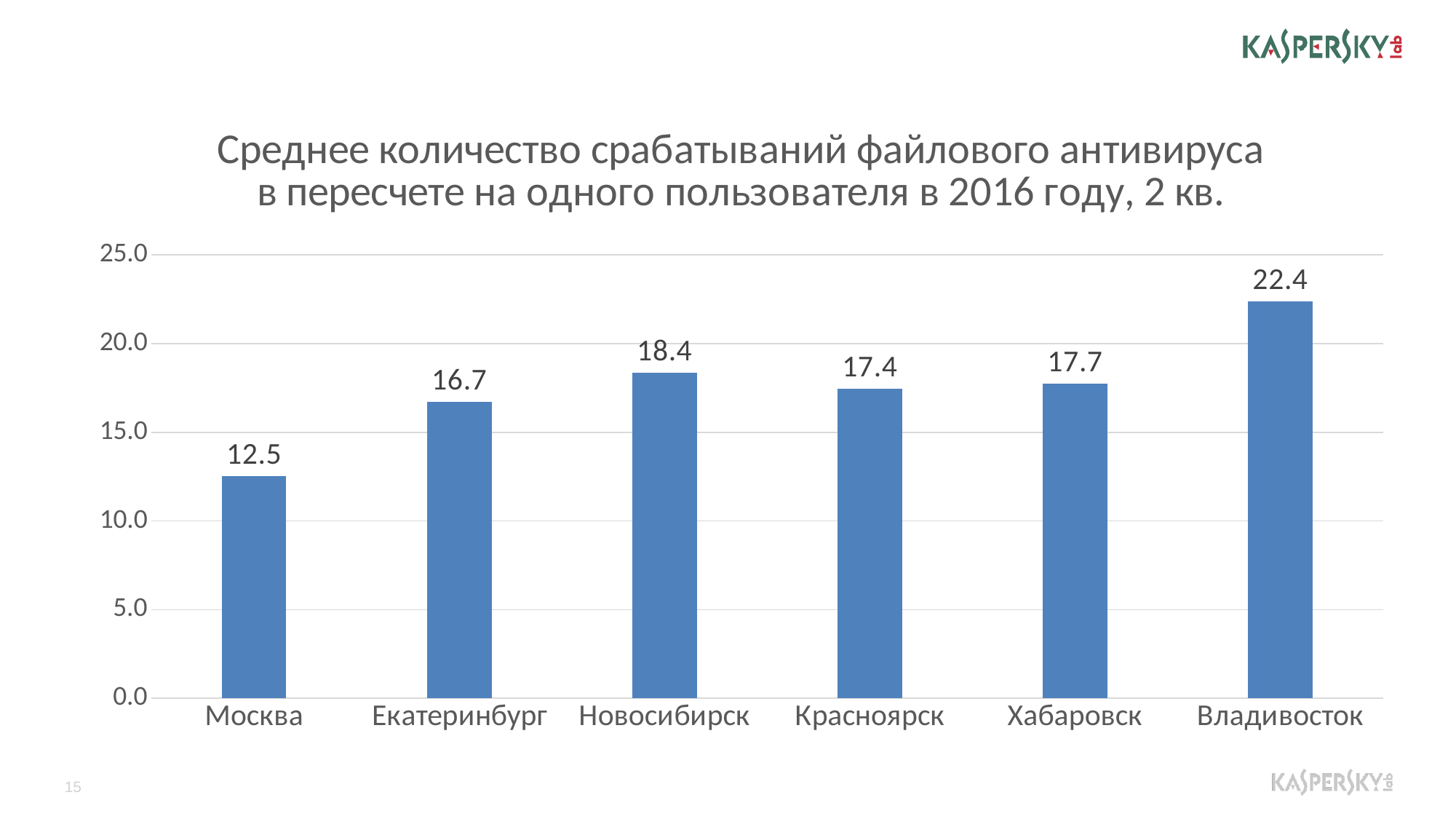
What kind of chart is shown on the slide? bar chart Is the value for Хабаровск greater or less than 15.0? greater How many cities are shown on the chart? 6 What is the difference between the values for Новосибирск and Екатеринбург? 1.7 What is the difference between the values for Владивосток and Москва? 9.9 Which is larger, the value for Екатеринбург or the value for Красноярск? Красноярск What is the value for Новосибирск? 18.4 Which city has the highest value? Владивосток What is the value for Владивосток? 22.4 What is the value for Красноярск? 17.4 Which city has the lowest value? Москва What is the value for Москва? 12.5